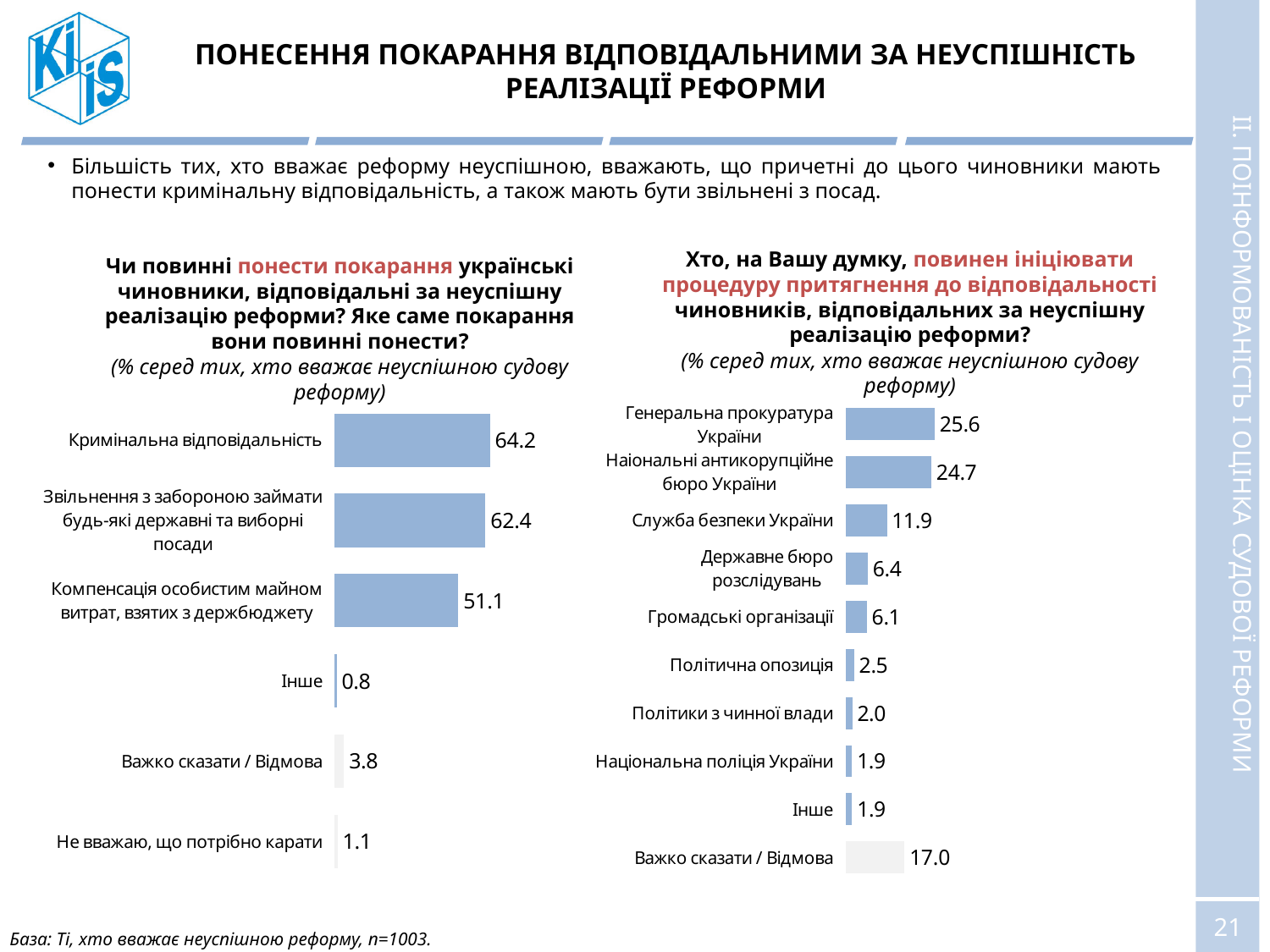
In the left chart, what is the value for Компенсація особистим майном витрат, взятих з держбюджету? 51.1 In the right chart, which is larger: Державне бюро розслідувань or Громадські організації? Державне бюро розслідувань In the right chart, what is the value for Важко сказати / Відмова? 17.0 In the left chart, which category has the lowest value? Інше In the left chart, how many categories are shown? 6 In the left chart, what is the difference between Кримінальна відповідальність and Звільнення з забороною займати будь-які державні та виборні посади? 1.8 In the right chart, what is the difference between Генеральна прокуратура України and Наіональні антикорупційне бюро України? 0.9 What type of chart is the left chart? Bar chart In the right chart, what is the value for Служба безпеки України? 11.9 In the right chart, which category has the highest value? Генеральна прокуратура України In the left chart, what is the value for Кримінальна відповідальність? 64.2 In the right chart, how many categories are shown? 10